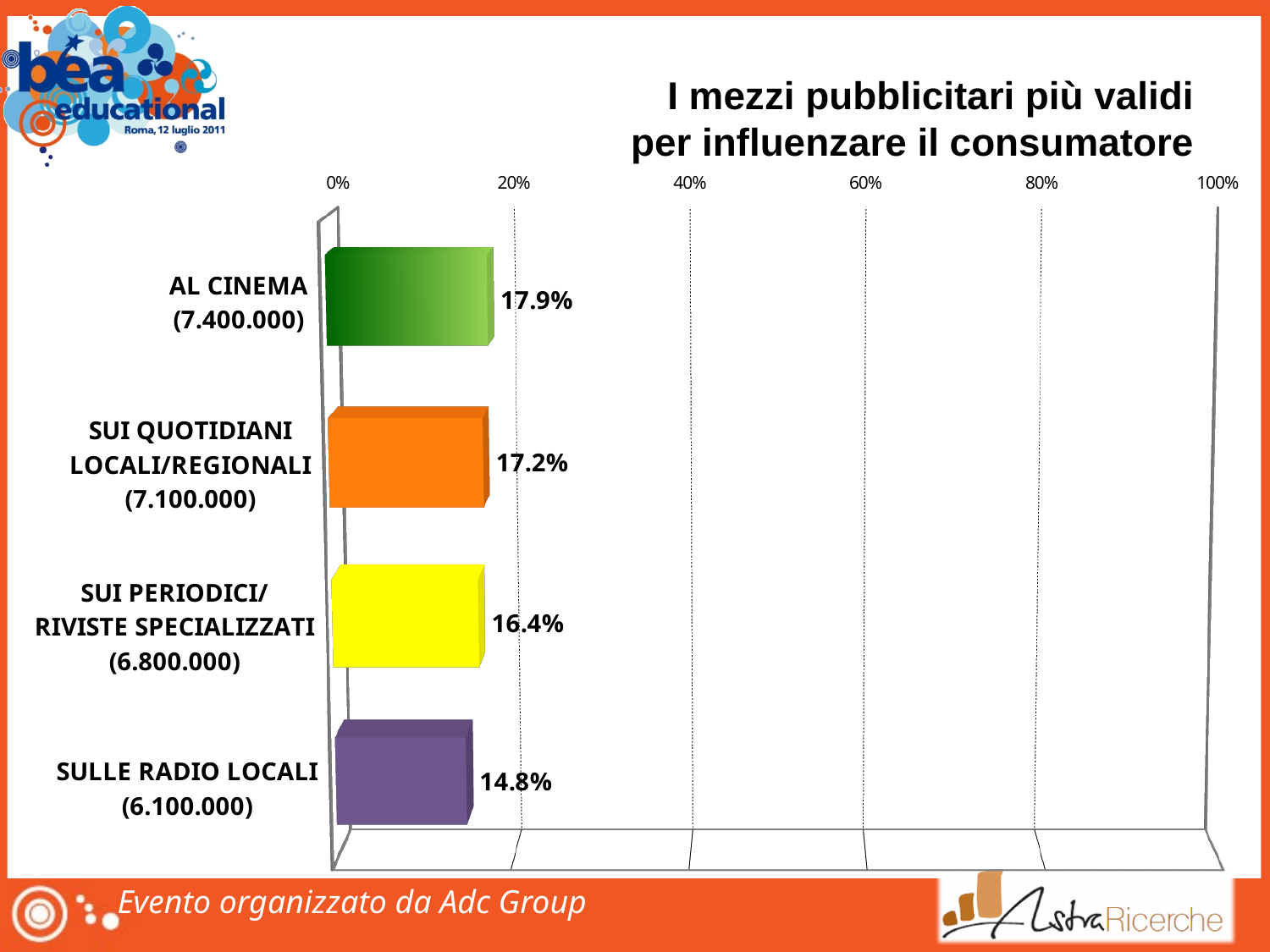
What is the value for SUI QUOTIDIANI LOCALI/REGIONALI? 17.2% What is the value for SULLE RADIO LOCALI? 14.8% What is the difference between the values for SUI QUOTIDIANI LOCALI/REGIONALI and SUI PERIODICI/RIVISTE SPECIALIZZATI? 0.8% Which category has the lowest value? SULLE RADIO LOCALI Which category has the highest value? AL CINEMA What is the difference between the values for AL CINEMA and SULLE RADIO LOCALI? 3.1% Which is larger, the value for SUI PERIODICI/RIVISTE SPECIALIZZATI or the value for SULLE RADIO LOCALI? SUI PERIODICI/RIVISTE SPECIALIZZATI How many categories are shown in the chart? 4 What is the value for SUI PERIODICI/RIVISTE SPECIALIZZATI? 16.4% Is the value for AL CINEMA greater or less than 20%? less What kind of chart is shown on the slide? bar chart What is the value for AL CINEMA? 17.9%